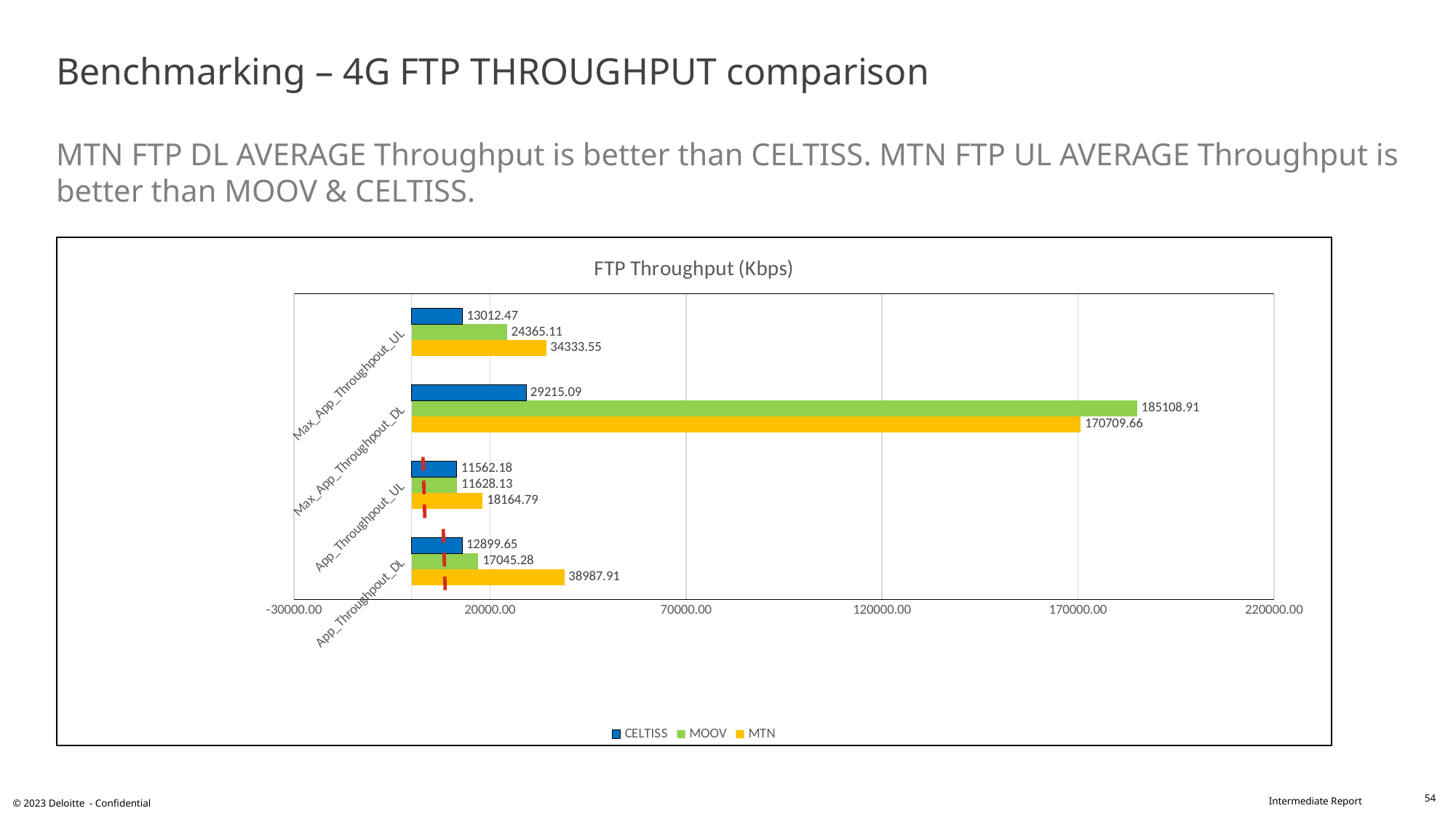
Which operator has the highest value for App_Throughput_UL? MTN What is the MOOV value for Max_App_Throughput_DL? 185108.91 Which is larger for Max_App_Throughput_DL: the MOOV value or the MTN value? MOOV What is the difference between the MTN and CELTISS values for App_Throughput_DL? 26088.26 What is the CELTISS value for App_Throughput_DL? 12899.65 Which operator has the lowest value for Max_App_Throughput_DL? CELTISS What is the title of the chart? FTP Throughput (Kbps) Is the MTN value for Max_App_Throughput_DL greater or less than 120000.00? greater What type of chart is shown on the slide? Bar chart How many series does the legend list? 3 What is the MTN value for Max_App_Throughput_UL? 34333.55 How many categories are shown on the chart? 4